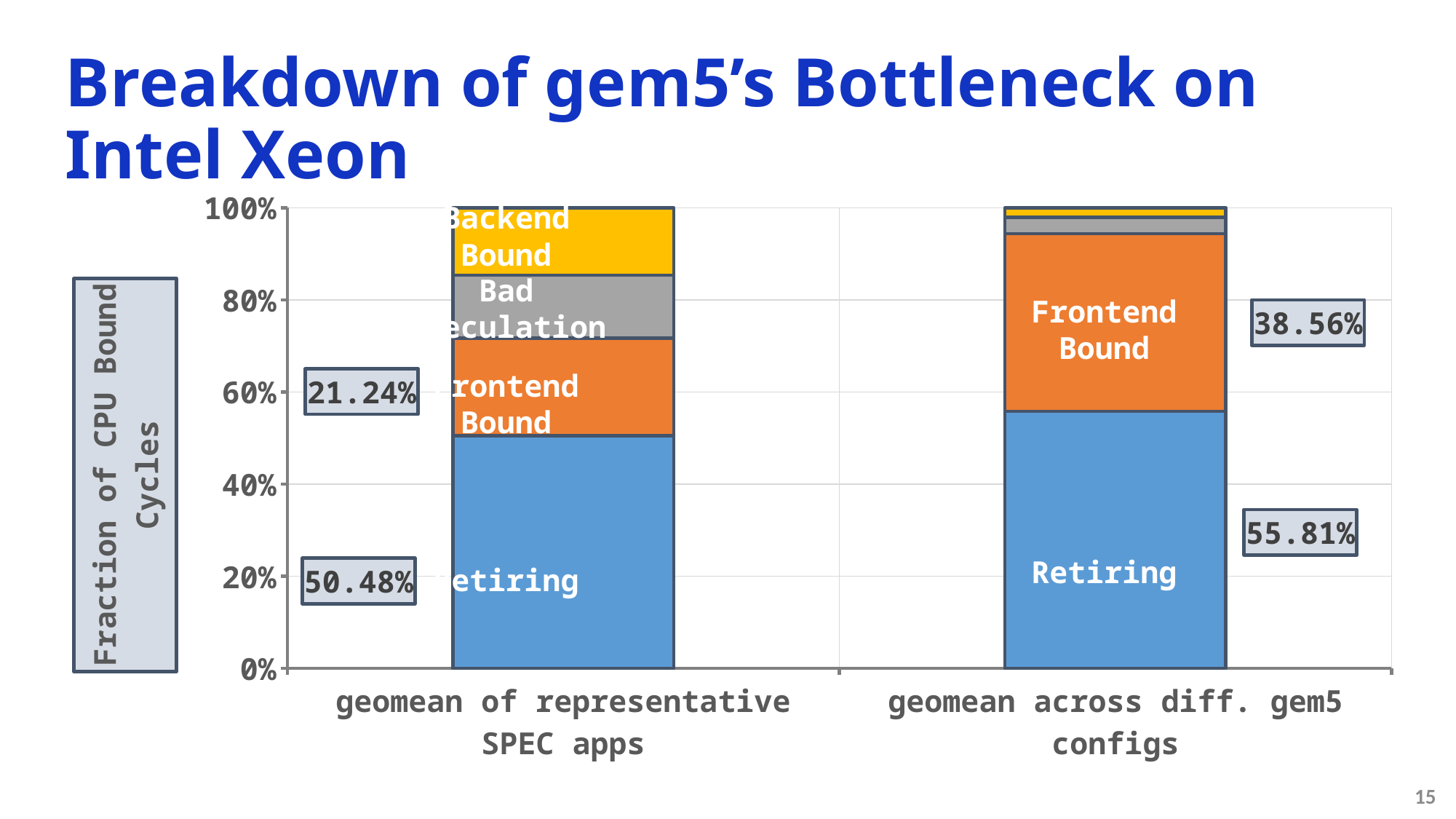
What is the Frontend Bound value for geomean of representative SPEC apps? 21.24% What kind of chart is shown on the slide? stacked bar chart What is the Retiring value for geomean of representative SPEC apps? 50.48% Which category has the higher Frontend Bound value? geomean across diff. gem5 configs What is the difference between the Retiring values of the two categories? 5.33% What is the difference between the Frontend Bound values of the two categories? 17.32% How many categories are shown on the x axis? 2 What is the Frontend Bound value for geomean across diff. gem5 configs? 38.56% Is the Backend Bound segment for geomean of representative SPEC apps greater or less than 20%? less Which category has the higher Retiring value? geomean across diff. gem5 configs What is the Retiring value for geomean across diff. gem5 configs? 55.81% What is the y-axis label of the chart? Fraction of CPU Bound Cycles